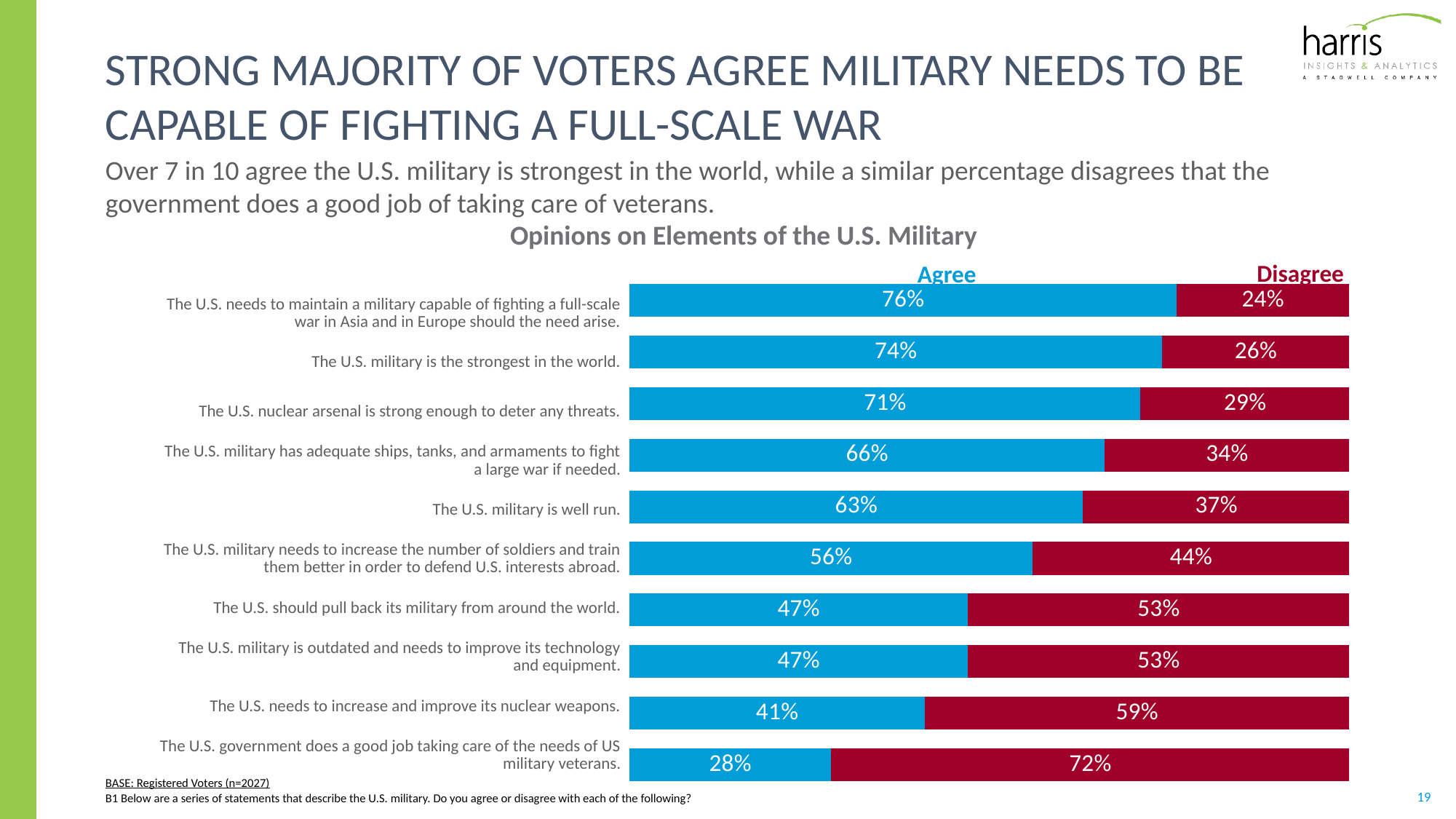
What is the difference between the Agree and Disagree percentages for the statement that the U.S. nuclear arsenal is strong enough to deter any threats? 42% What is the Agree value for the statement that the U.S. military is well run? 63% How many statements are shown in the chart? 10 What percentage of voters disagree that the U.S. government does a good job taking care of the needs of US military veterans? 72% What percentage of voters agree that the U.S. military is the strongest in the world? 74% What is the total of the Agree and Disagree values for the statement that the U.S. should pull back its military from around the world? 100% What is the title of the chart? Opinions on Elements of the U.S. Military Which statement has the lowest Agree percentage? The U.S. government does a good job taking care of the needs of US military veterans. Which is larger: the Agree percentage for 'The U.S. military has adequate ships, tanks, and armaments to fight a large war if needed' or the Agree percentage for 'The U.S. needs to increase and improve its nuclear weapons'? The U.S. military has adequate ships, tanks, and armaments to fight a large war if needed What kind of chart is shown on the slide? Stacked bar chart How many series does the chart show? 2 Which statement has the highest Agree percentage? The U.S. needs to maintain a military capable of fighting a full-scale war in Asia and in Europe should the need arise.